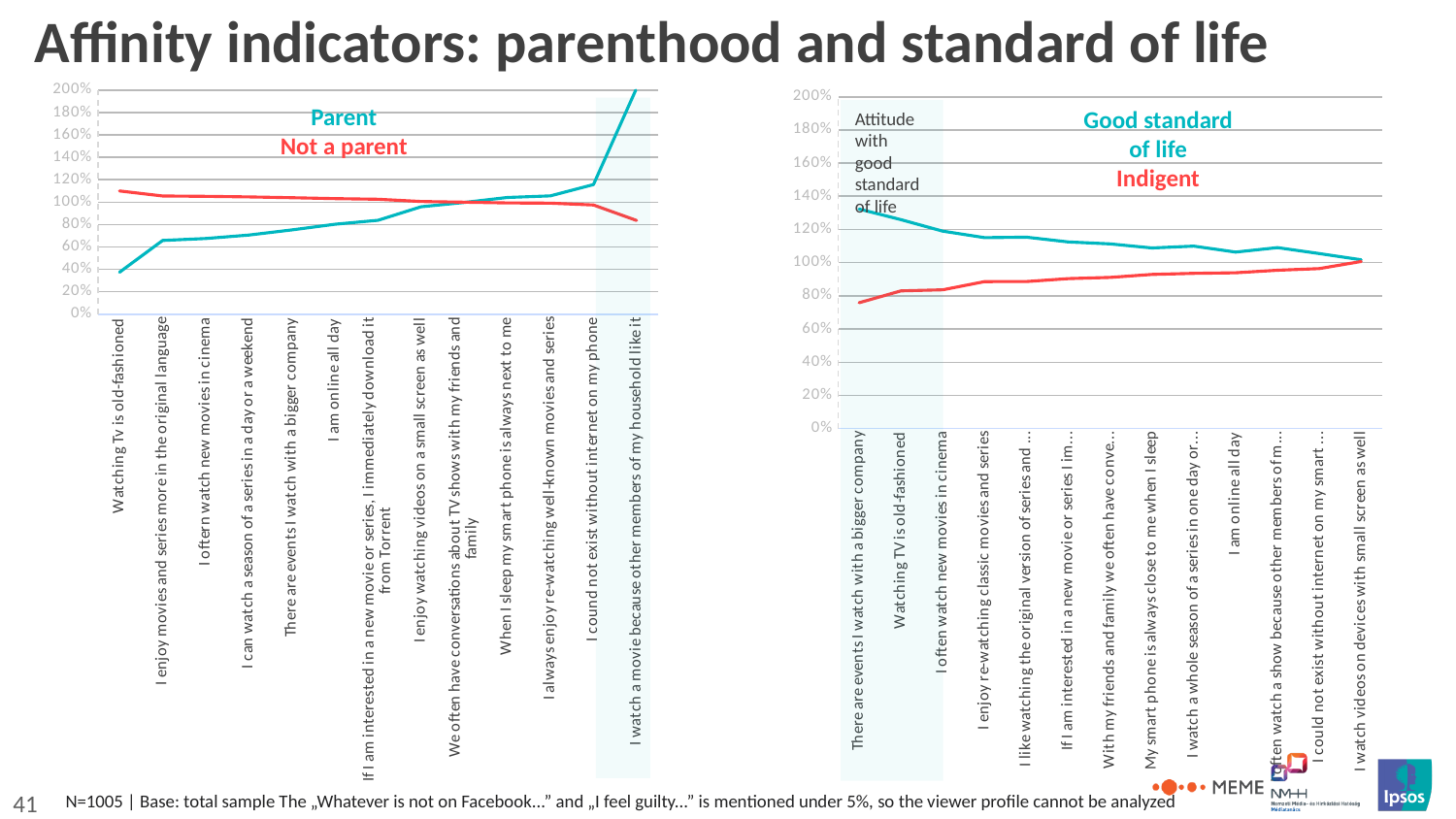
In the left chart, for which category is the Parent series highest? I watch a movie because other members of my household like it How many series does the legend of the right chart list? 2 In the left chart, is the Parent value for 'Watching Tv is old-fashioned' greater or less than 60%? less In the left chart, is the Parent value for 'I watch a movie because other members of my household like it' greater or less than 160%? greater What are the two series named in the left chart? Parent and Not a parent In the left chart, does the Parent line generally rise or fall from left to right along the x axis? rise What type of chart is the left chart on the slide? Line chart In the left chart, which series has the higher value for 'Watching Tv is old-fashioned', Parent or Not a parent? Not a parent In the right chart, does the 'Good standard of life' line generally rise or fall from left to right along the x axis? fall How many series does the legend of the left chart list? 2 How many categories are plotted along the x axis of the left chart? 13 In the right chart, is the 'Good standard of life' value for 'There are events I watch with a bigger company' greater or less than 120%? greater